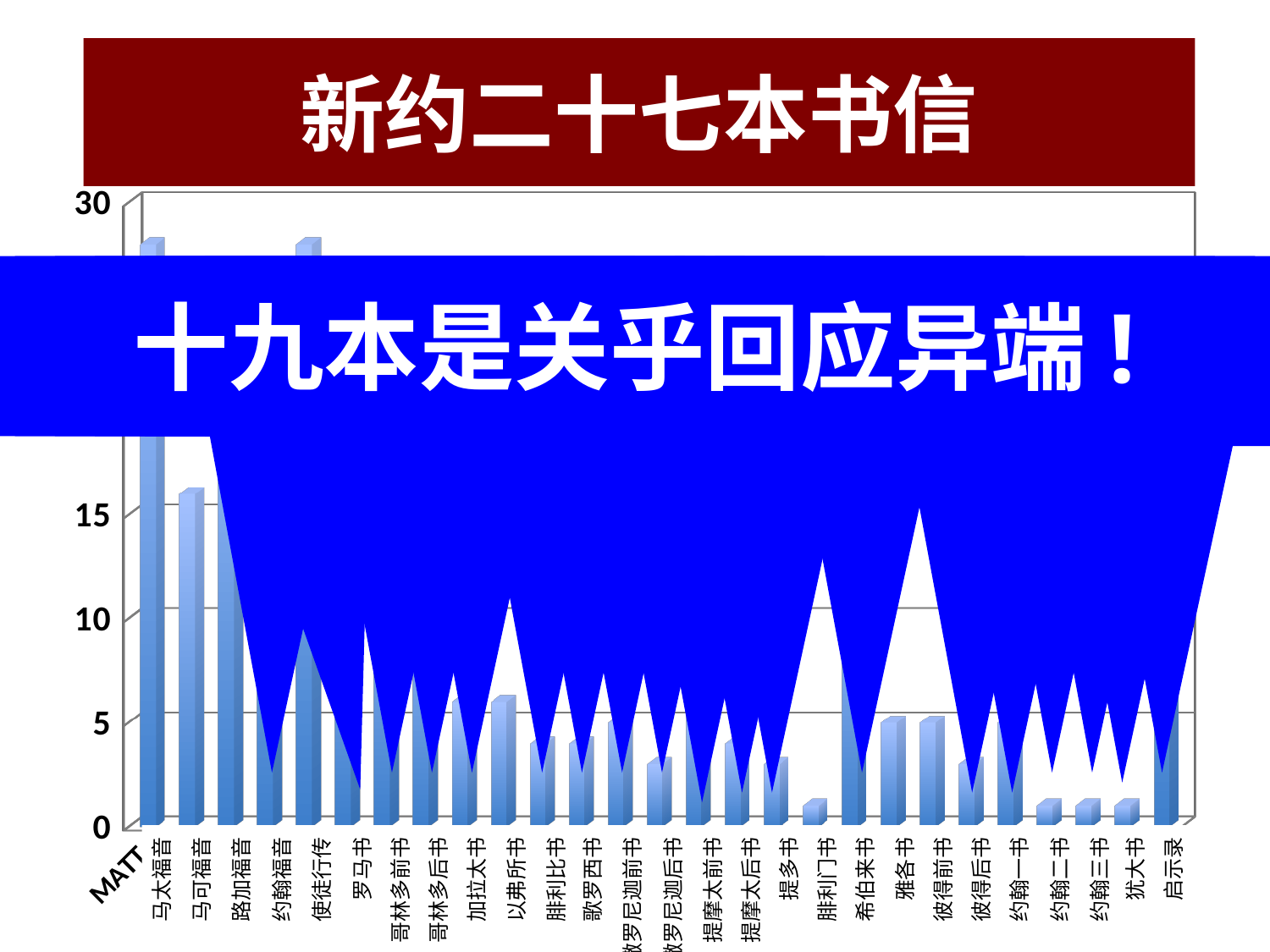
What text is written on the blue banner overlaying the chart? 十九本是关乎回应异端！ Which has the larger value, 启示录 or 雅各书? 启示录 Is the value for 马可福音 greater or less than 15? greater What kind of chart is shown on the slide? bar chart Is the value for 约翰二书 greater or less than 5? less Is the value for 帖撒罗尼迦后书 greater or less than 5? less Which has the larger value, 马可福音 or 腓利门书? 马可福音 What is the title of the chart on the slide? 新约二十七本书信 What is the highest value shown on the vertical axis? 30